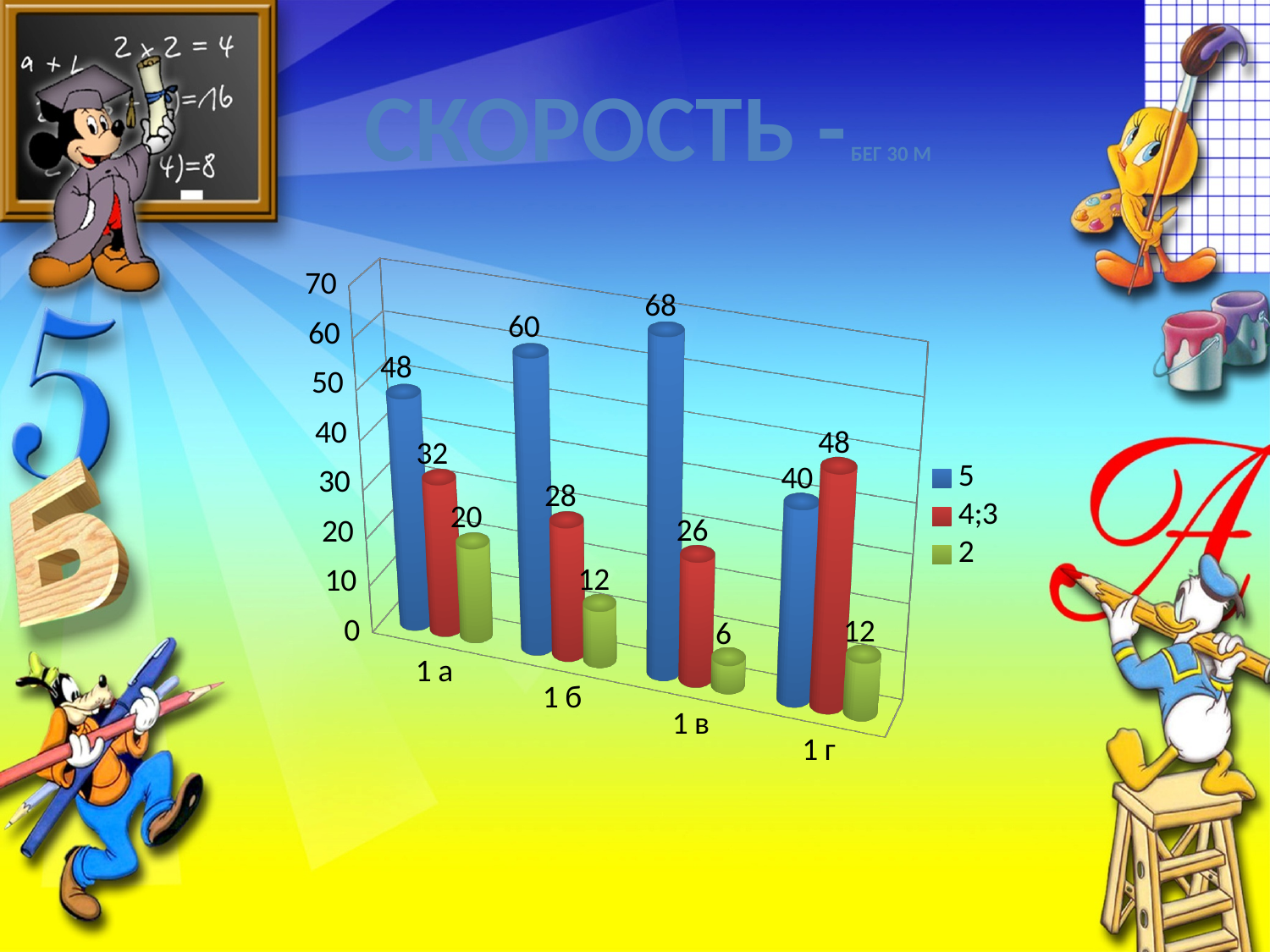
What is the value for series "5" in category "1 в"? 68 How many series does the legend list? 3 What is the difference between the series "5" values for "1 б" and "1 а"? 12 What is the value for series "4;3" in category "1 г"? 48 Which category has the highest value for series "5"? 1 в What is the value for series "2" in category "1 б"? 12 In category "1 г", which series has the larger value, "5" or "4;3"? 4;3 What colour are the bars for series "2"? green Which category has the lowest value for series "2"? 1 в How many categories are shown on the x axis? 4 What is the value for series "4;3" in category "1 а"? 32 What kind of chart is shown on the slide? bar chart